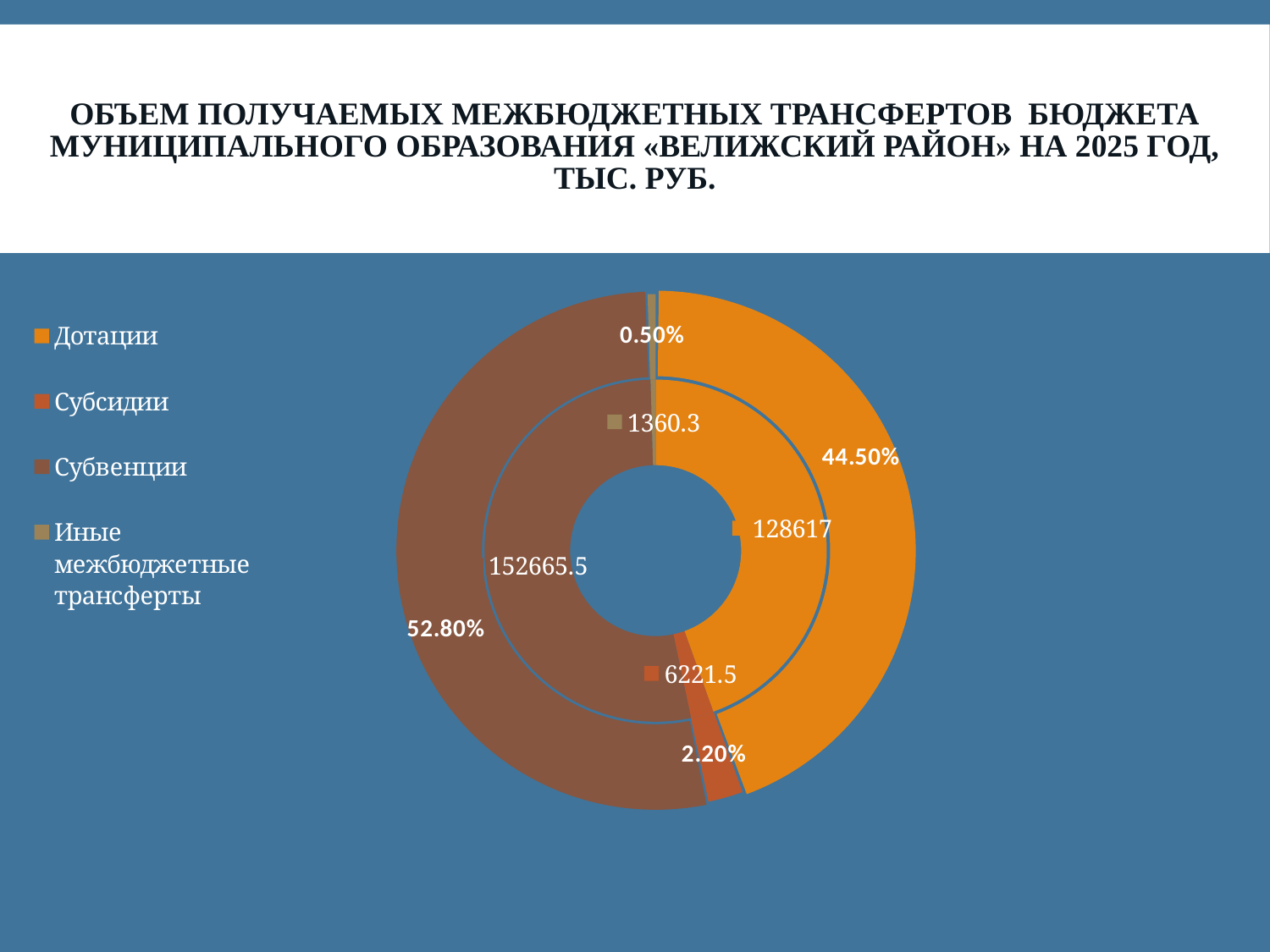
Which category has the largest value? Субвенции How many categories does the legend list? 4 What is the value for Иные межбюджетные трансферты shown on the inner ring? 1360.3 Which is larger, the value for Субсидии or the value for Иные межбюджетные трансферты? Субсидии What is the difference between the values for Субвенции and Дотации? 24048.5 Which category has the smallest value? Иные межбюджетные трансферты What is the value for Дотации shown on the inner ring? 128617 What percentage share is shown for Субвенции on the outer ring? 52.80% What is the value for Субсидии shown on the inner ring? 6221.5 What kind of chart is shown on the slide? doughnut chart What is the value for Субвенции shown on the inner ring? 152665.5 What percentage share is shown for Дотации on the outer ring? 44.50%